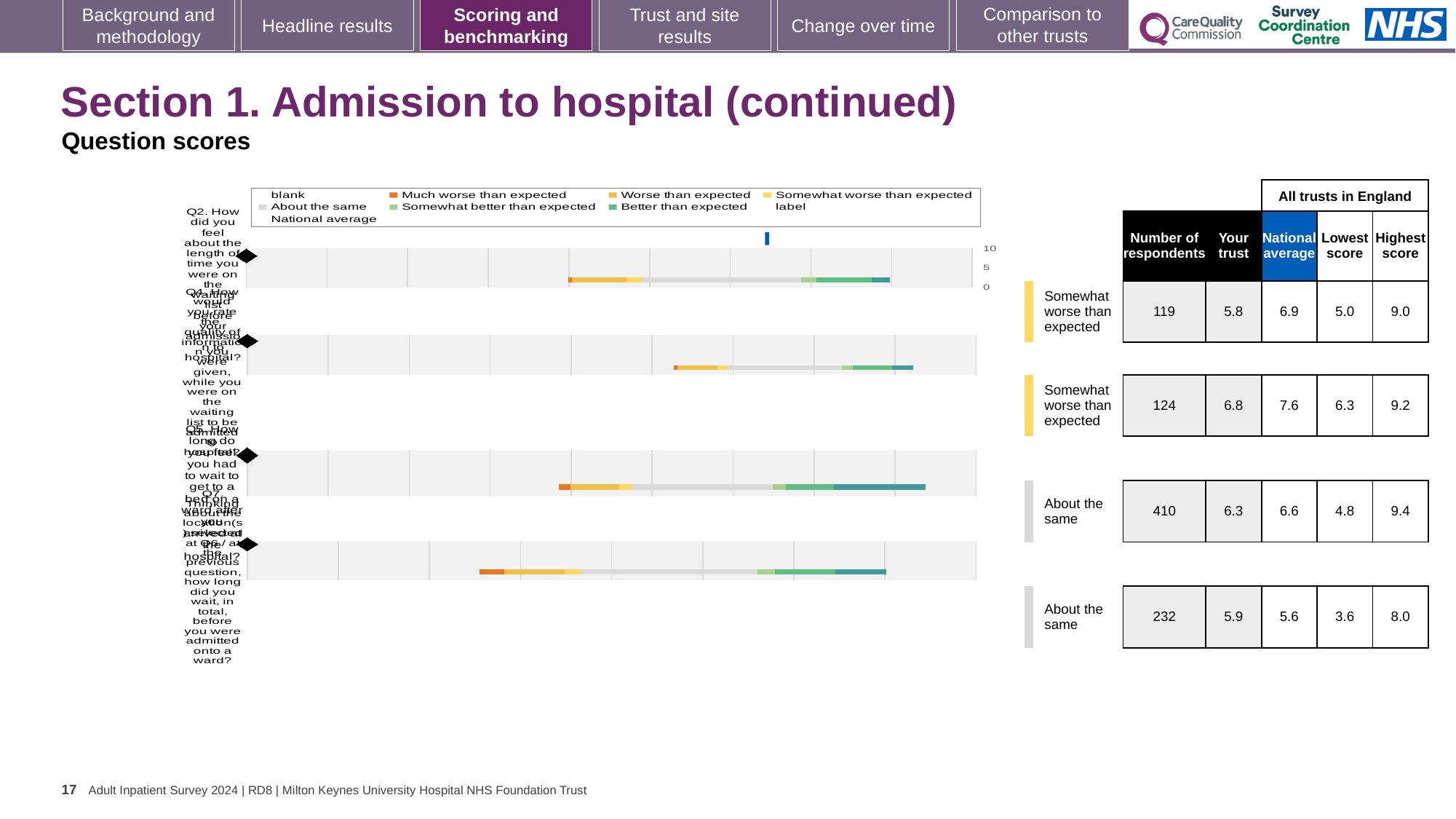
In the table beside the chart, what is the national average for the third question row? 6.6 In the table beside the chart, what is the 'Your trust' score for the second question row? 6.8 In the table beside the chart, is the 'Your trust' score for the fourth question row larger or smaller than its national average? larger In the table beside the chart, what is the number of respondents for the first question row? 119 What is the highest value shown on the chart's axis? 10 How many entries does the chart legend list? 9 What kind of chart is shown on the slide? bar chart In the table beside the chart, which question row has the largest number of respondents? the third row (410) Which legend entry is shown in orange in the chart? Much worse than expected In the table beside the chart, what is the difference between the national average and the 'Your trust' score for the first question row? 1.1 How many question rows (bars) are plotted in the chart? 4 In the table beside the chart, what is the highest score for the fourth question row? 8.0